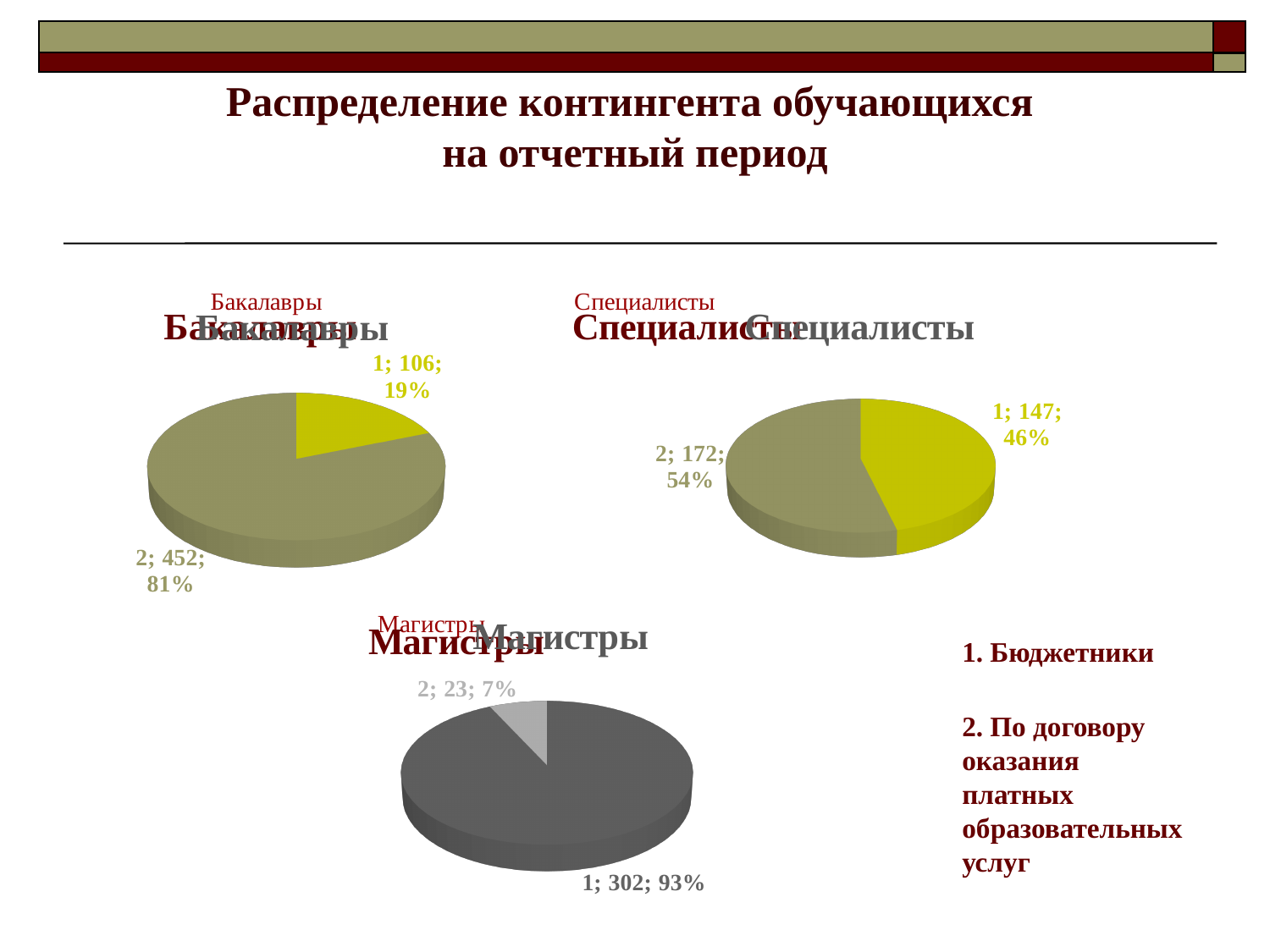
In the "Бакалавры" chart, what share of the pie does category 2 have? 81% How many pie charts are on the slide? 3 In the "Специалисты" chart, what value is shown for category 2? 172 In the "Бакалавры" chart, what is the total of the two slices? 558 In the "Магистры" chart, which category has the smallest slice? 2 In the "Магистры" chart, what value is shown for category 1? 302 In the "Магистры" chart, what share of the pie does category 2 have? 7% In the "Специалисты" chart, what share of the pie does category 1 have? 46% In the "Бакалавры" chart, which category has the largest slice? 2 In the "Специалисты" chart, what is the difference between the values for category 2 and category 1? 25 What kind of chart is the "Магистры" chart? Pie chart In the "Бакалавры" chart, what value is shown for category 1? 106